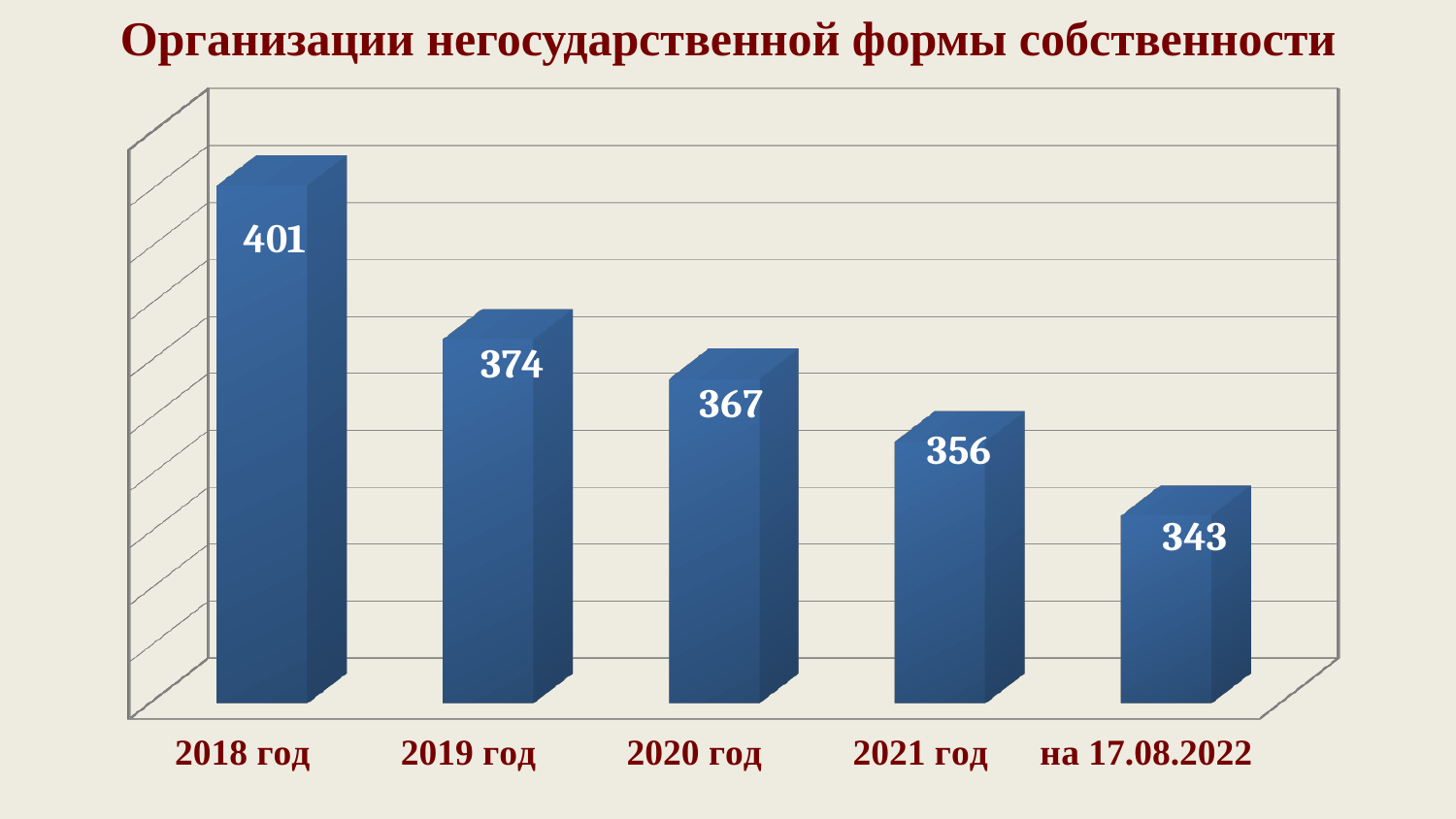
What is the value for 2020 год? 367 What is the difference between the values for 2021 год and на 17.08.2022? 13 Which category has the highest value? 2018 год Which is larger, the value for 2019 год or the value for 2021 год? 2019 год What is the value for 2018 год? 401 What kind of chart is this? bar chart Which category has the lowest value? на 17.08.2022 What is the difference between the values for 2018 год and 2019 год? 27 What is the title of the chart? Организации негосударственной формы собственности What is the value for на 17.08.2022? 343 How many categories are shown on the chart? 5 Do the values rise or fall from 2018 год to на 17.08.2022? fall